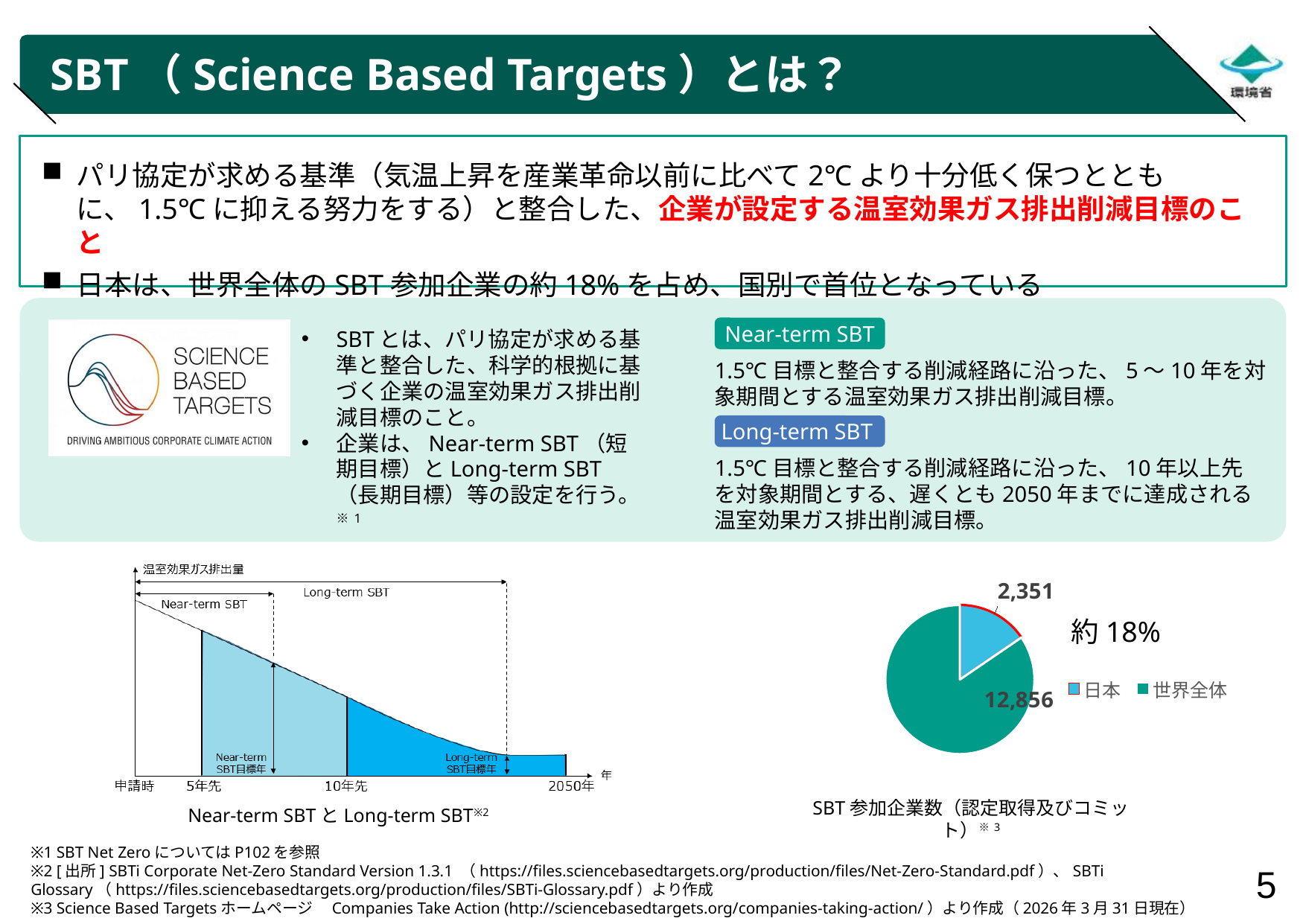
What kind of chart is the chart on the right of the slide (SBT参加企業数)? pie chart In the pie chart on the right, what is the difference between the value for 世界全体 and the value for 日本? 10,505 How many entries does the legend of the pie chart on the right list? 2 In the pie chart on the right, what is the value for 日本? 2,351 What percentage is annotated next to the pie chart on the right? 約18% What is the caption/title shown below the pie chart on the right? SBT参加企業数（認定取得及びコミット） In the pie chart on the right, which category has the largest value? 世界全体 How many slices does the pie chart on the right have? 2 In the pie chart on the right, what is the value for 世界全体? 12,856 In the pie chart on the right, which category has the smallest value? 日本 In the pie chart on the right, which is larger, the value for 日本 or the value for 世界全体? 世界全体